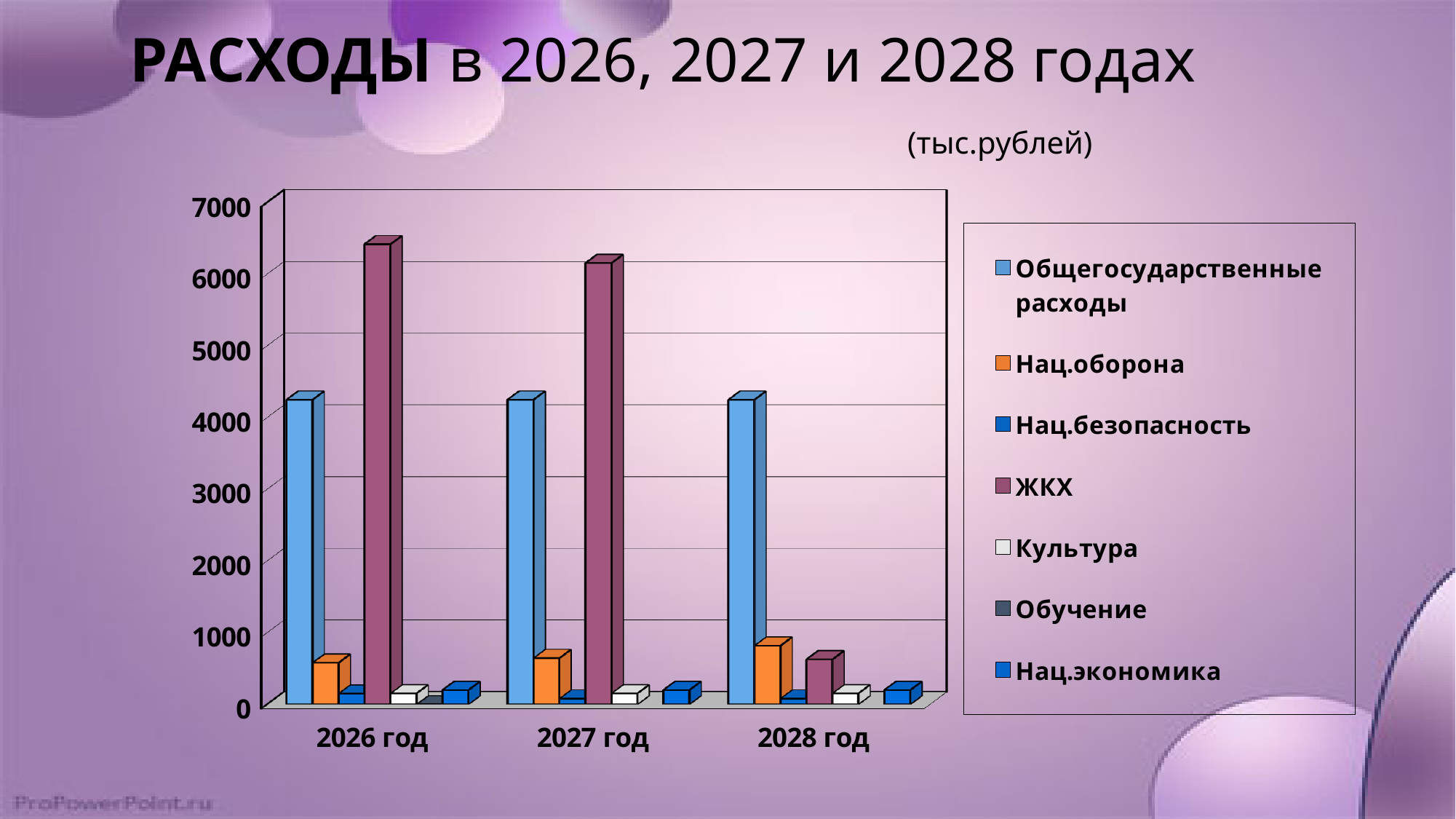
Which is larger: ЖКХ in 2027 год or ЖКХ in 2028 год? ЖКХ in 2027 год How many series does the legend list? 7 Is the value for ЖКХ in 2026 год greater or less than 6000? greater Which series has the highest value in 2028 год? Общегосударственные расходы Is the value for Общегосударственные расходы in 2027 год greater or less than 4000? greater What unit is stated for the values on the slide? тыс.рублей Which series has the highest value in 2026 год? ЖКХ Is the value for ЖКХ in 2028 год greater or less than 1000? less What kind of chart is shown on the slide? bar chart Does the value for ЖКХ rise or fall from 2026 год to 2028 год? fall How many year categories are shown on the x axis? 3